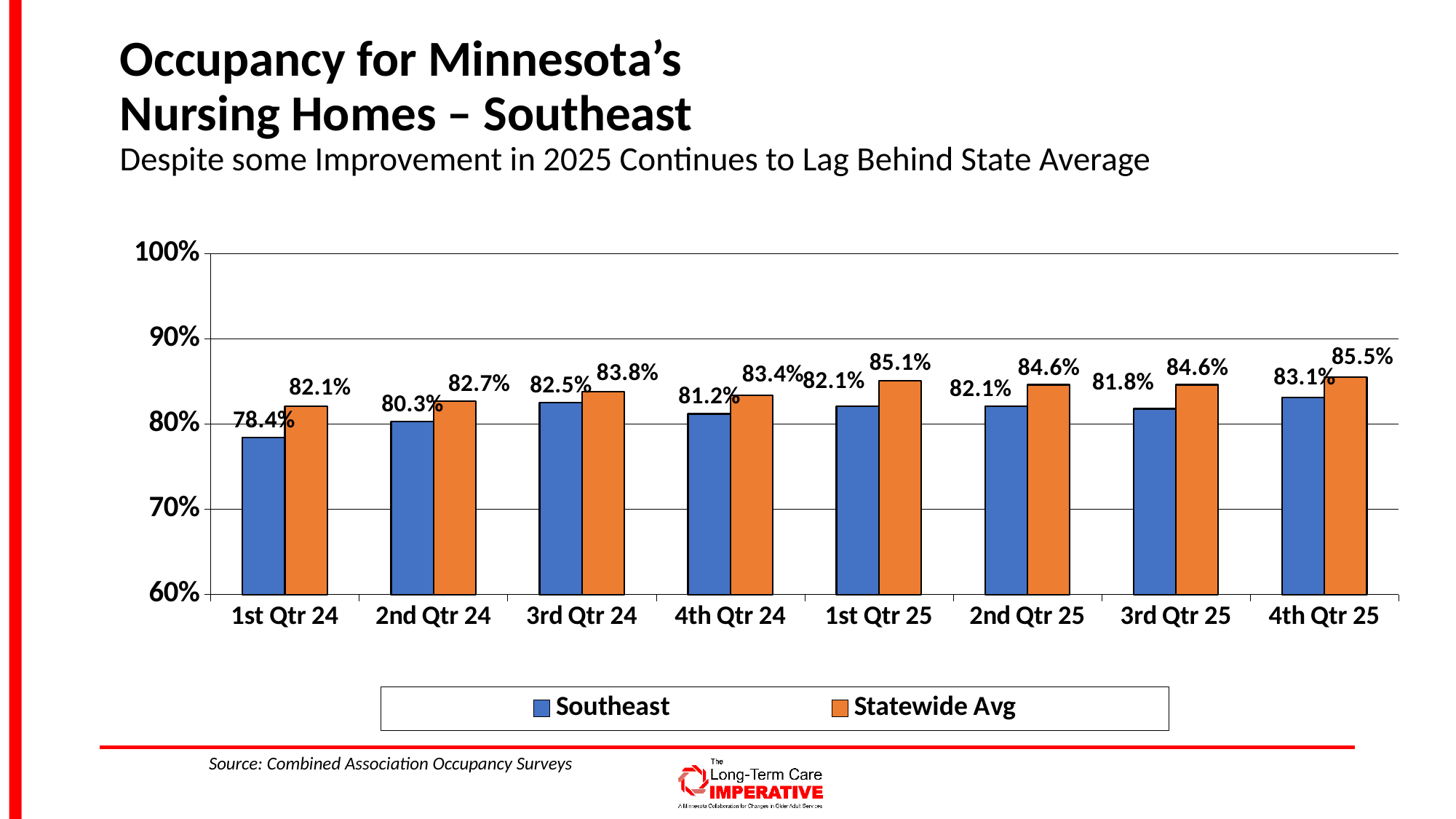
What colour represents the Southeast series in the legend? blue Does the Statewide Avg occupancy generally rise or fall from 1st Qtr 24 to 4th Qtr 25? rise What kind of chart is shown on the slide? bar chart How many series does the legend list? 2 What is the Statewide Avg occupancy value for 4th Qtr 25? 85.5% In which quarter is the Statewide Avg occupancy lowest? 1st Qtr 24 Is the Southeast value for 1st Qtr 24 greater or less than 80%? less How many quarters are shown on the x axis? 8 What is the Southeast occupancy value for 1st Qtr 24? 78.4% What is the difference between the Statewide Avg and Southeast values in 4th Qtr 25? 2.4 percentage points In which quarter is the Southeast occupancy highest? 4th Qtr 25 In 3rd Qtr 24, which is larger: the Southeast value or the Statewide Avg value? Statewide Avg